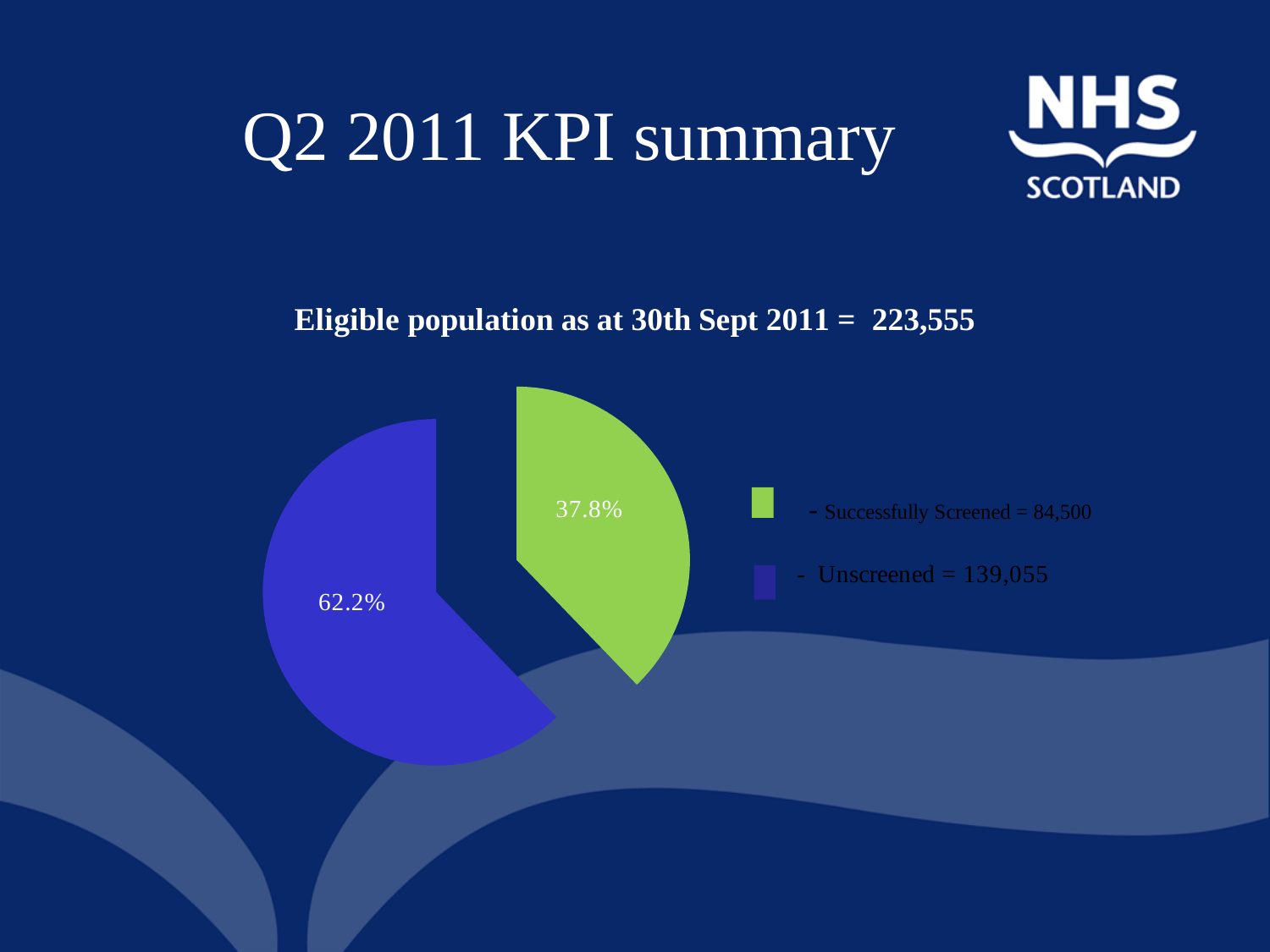
What percentage of the pie is labelled for the Successfully Screened slice? 37.8% Which is larger, the Unscreened count or the Successfully Screened count? Unscreened Which slice of the pie is the smallest? Successfully Screened What is the eligible population stated above the chart? 223,555 According to the legend, how many people were Successfully Screened? 84,500 Which slice of the pie is the largest? Unscreened What percentage of the pie is labelled for the Unscreened slice? 62.2% What colour is the Successfully Screened slice? green According to the legend, how many people were Unscreened? 139,055 What is the difference between the Unscreened count and the Successfully Screened count? 54,555 What kind of chart is shown on the slide? pie chart How many slices does the pie chart have? 2